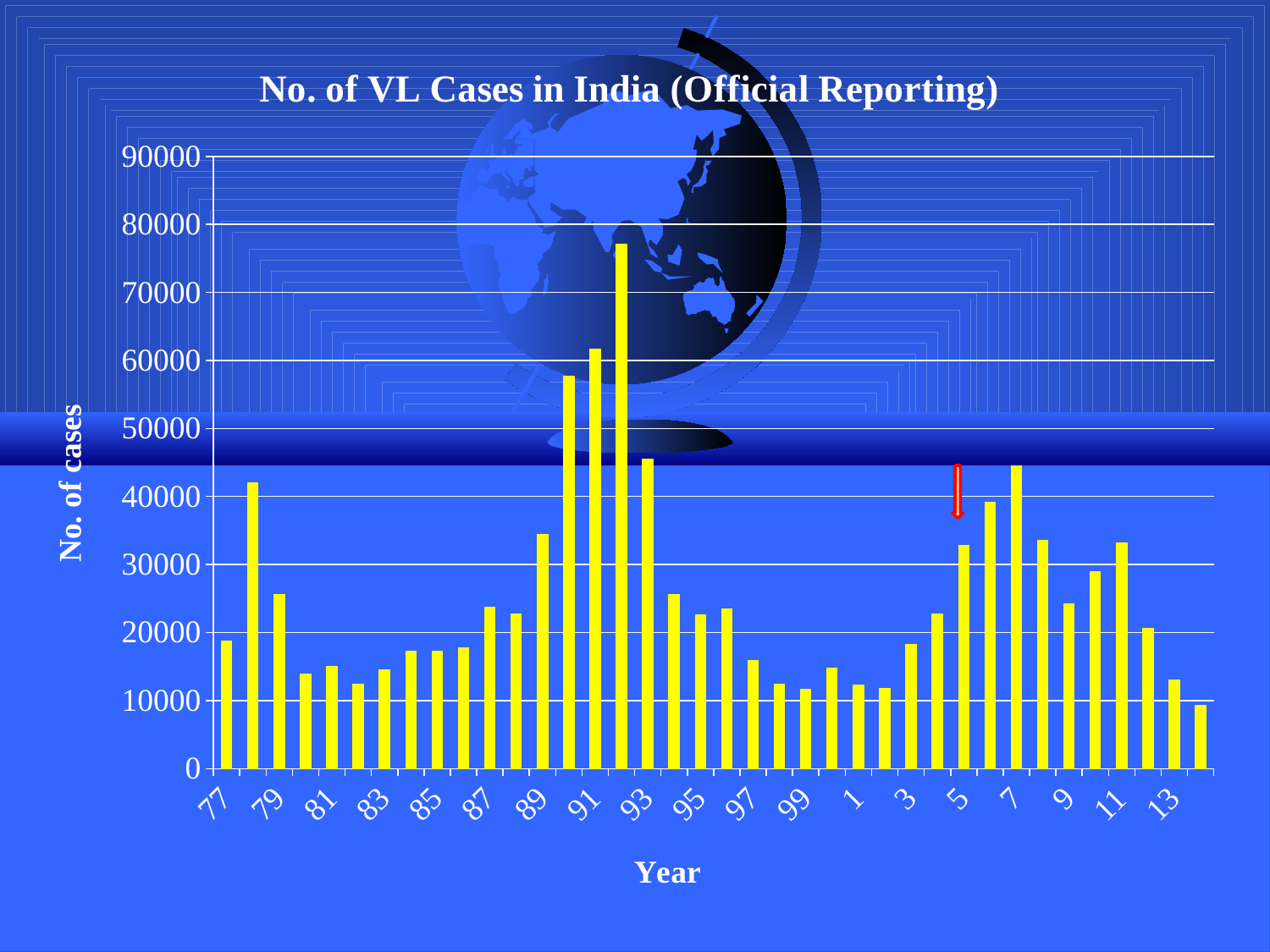
What is the label of the vertical axis? No. of cases Is the value for 90 greater or less than 60000? less Do the values rise or fall from 89 to 92? rise Is the value for 92 greater or less than 70000? greater What type of chart is shown on the slide? Bar chart Which year has more VL cases, 78 or 79? 78 Which year has more VL cases, 5 or 7? 7 Is the value for 78 greater or less than 40000? greater What is the title of the chart? No. of VL Cases in India (Official Reporting) Which year has the highest number of VL cases? 92